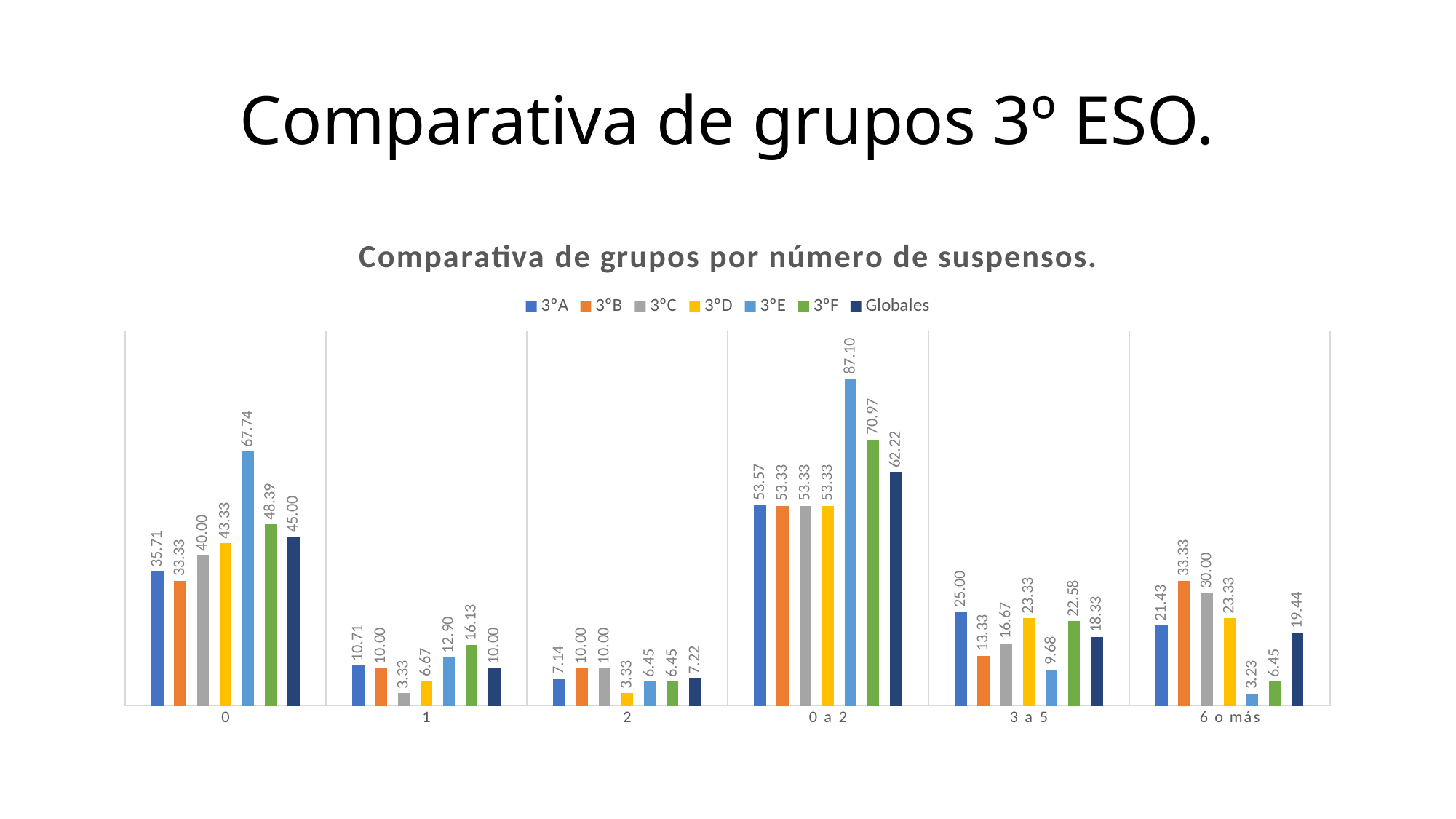
How many categories are shown on the x axis? 6 What is the value for 3ºE in the "0" category? 67.74 What is the Globales value for the "0 a 2" category? 62.22 What is the difference between the 3ºC and 3ºD values in the "1" category? 3.34 Which series has the highest value in the "0 a 2" category? 3ºE What is the value for 3ºB in the "6 o más" category? 33.33 What is the title of the chart? Comparativa de grupos por número de suspensos. How many series does the legend list? 7 What is the difference between the 3ºE and 3ºF values in the "0 a 2" category? 16.13 In the "3 a 5" category, which is larger: the value for 3ºA or the value for 3ºD? 3ºA What kind of chart is shown on the slide? Bar chart Which series has the lowest value in the "6 o más" category? 3ºE